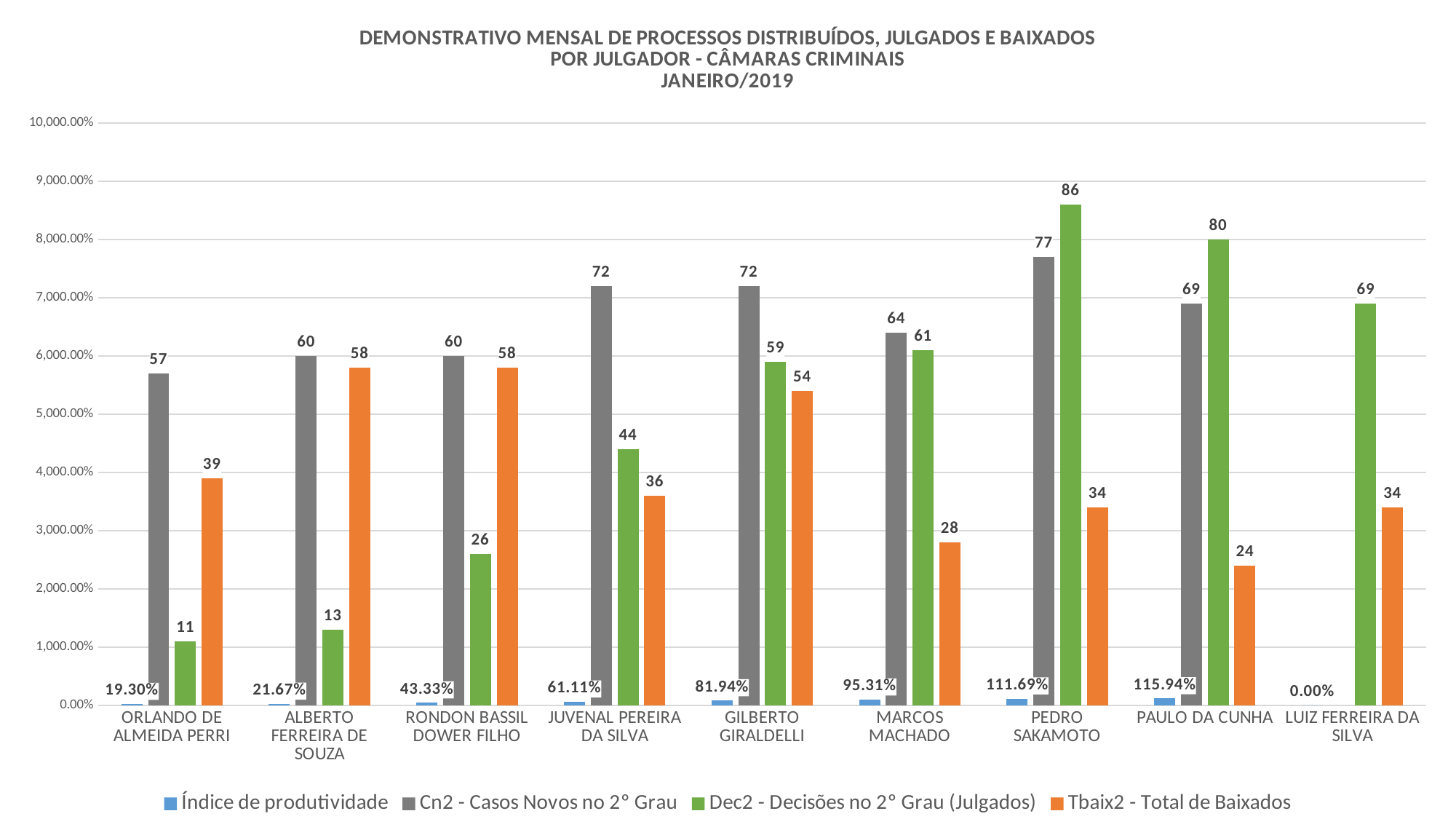
Which judge has the highest Dec2 - Decisões no 2° Grau (Julgados) value? PEDRO SAKAMOTO How many judges are shown on the x axis? 9 What is the Índice de produtividade for GILBERTO GIRALDELLI? 81.94% What is the value of Cn2 - Casos Novos no 2° Grau for PEDRO SAKAMOTO? 77 What colour represents Tbaix2 - Total de Baixados in the legend? Orange What is the difference between the Dec2 value and the Tbaix2 value for PEDRO SAKAMOTO? 52 Which judge has the lowest Dec2 - Decisões no 2° Grau (Julgados) value? ORLANDO DE ALMEIDA PERRI Who has the larger Cn2 - Casos Novos no 2° Grau value, JUVENAL PEREIRA DA SILVA or MARCOS MACHADO? JUVENAL PEREIRA DA SILVA What is the Tbaix2 - Total de Baixados value for LUIZ FERREIRA DA SILVA? 34 Does the Índice de produtividade rise or fall from ORLANDO DE ALMEIDA PERRI to PAULO DA CUNHA? Rises What kind of chart is shown on the slide? Bar chart How many series does the legend list? 4